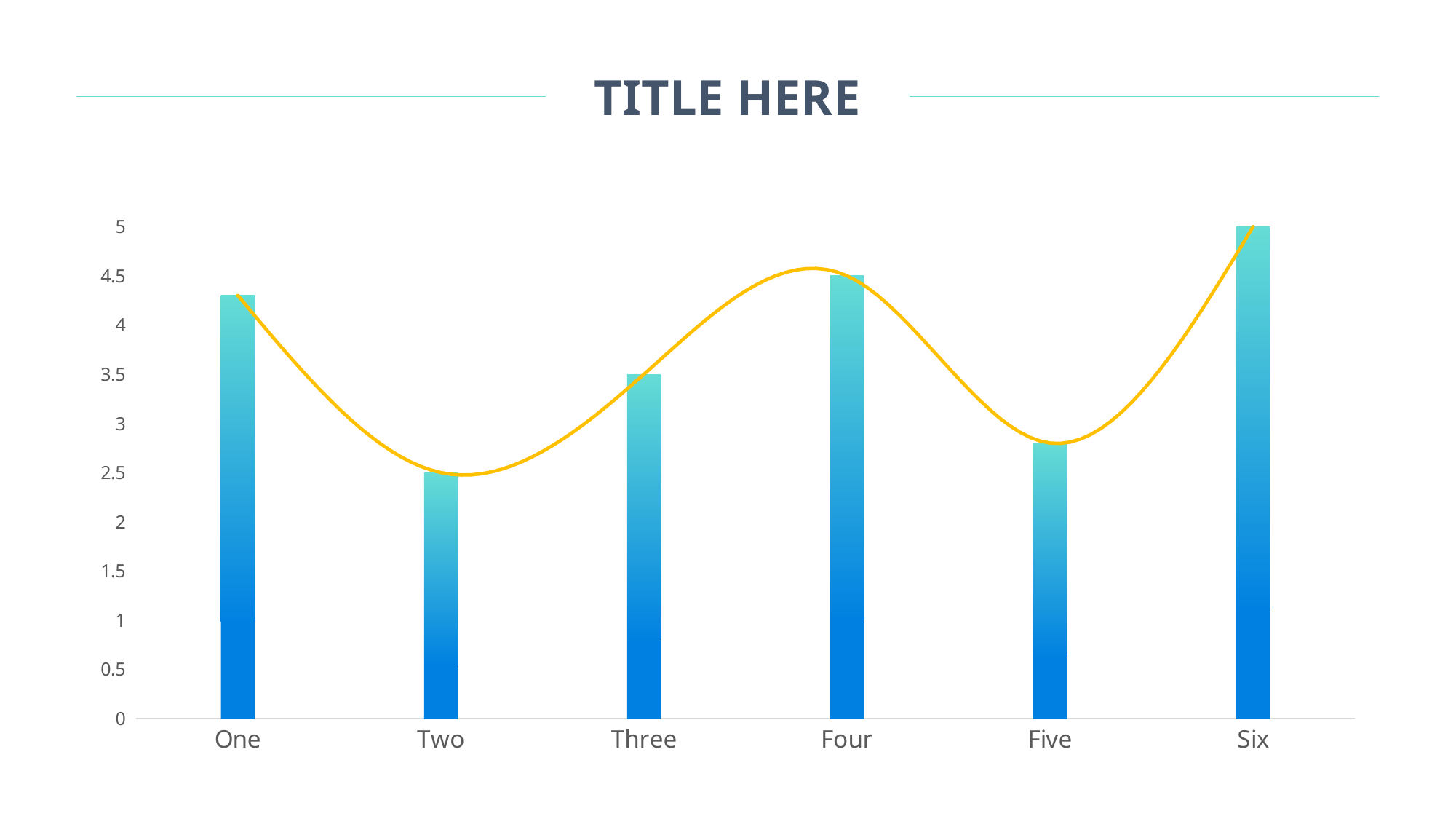
Is the value for One greater or less than 4? greater What is the title of the chart? TITLE HERE How many categories are shown on the x axis? 6 Which is larger, the value for Three or the value for Four? Four Which category has the lowest bar? Two Which category has the highest bar? Six What is the value of the bar for Four? 4.5 What is the value of the bar for Three? 3.5 Is the value for Five greater or less than 3? less What is the value of the bar for Six? 5 What is the value of the bar for Two? 2.5 What is the difference between the values for Six and Two? 2.5